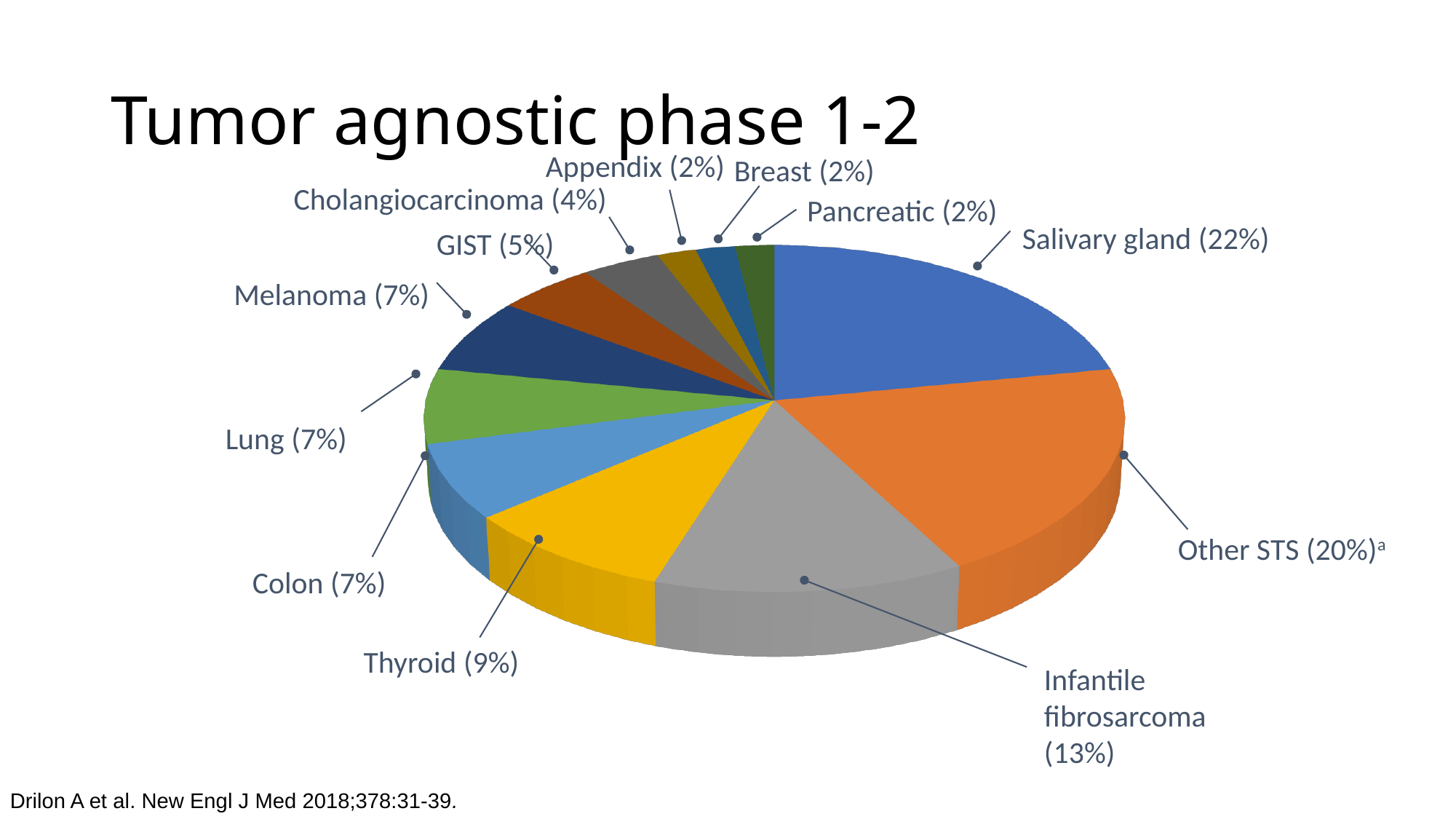
What is the combined percentage of Appendix, Breast and Pancreatic? 6% Which is larger, the Cholangiocarcinoma slice or the Melanoma slice? Melanoma What share of the pie does Salivary gland represent? 22% What kind of chart is shown on the slide? Pie chart What is the difference in percentage points between Salivary gland and Other STS? 2 What percentage is shown for Infantile fibrosarcoma? 13% What is the title of the slide containing the pie chart? Tumor agnostic phase 1-2 How many categories are shown in the pie chart? 12 Which category has the largest slice of the pie? Salivary gland What percentage is shown for GIST? 5% What percentage is shown for Thyroid? 9% What is the difference in percentage points between Infantile fibrosarcoma and Thyroid? 4